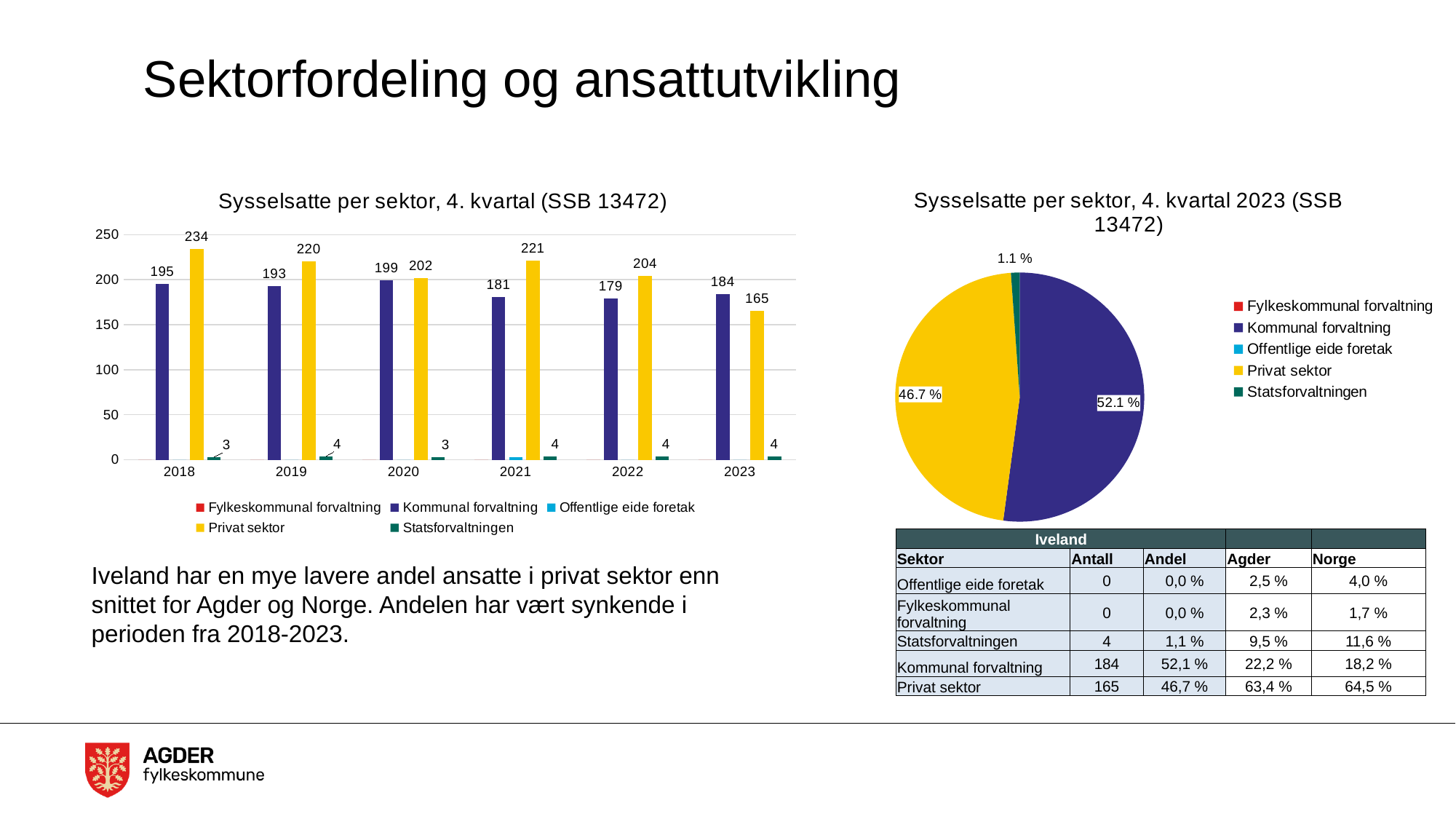
In the pie chart 'Sysselsatte per sektor, 4. kvartal 2023 (SSB 13472)', what share does Kommunal forvaltning have? 52.1 % In the pie chart 'Sysselsatte per sektor, 4. kvartal 2023 (SSB 13472)', what share does Statsforvaltningen have? 1.1 % In the bar chart 'Sysselsatte per sektor, 4. kvartal (SSB 13472)', in which year is Privat sektor highest? 2018 In the bar chart 'Sysselsatte per sektor, 4. kvartal (SSB 13472)', which is larger in 2021: Kommunal forvaltning or Privat sektor? Privat sektor In the bar chart 'Sysselsatte per sektor, 4. kvartal (SSB 13472)', what is the difference between Privat sektor and Kommunal forvaltning in 2023? 19 What kind of chart is 'Sysselsatte per sektor, 4. kvartal (SSB 13472)' on the left of the slide? Bar chart In the bar chart 'Sysselsatte per sektor, 4. kvartal (SSB 13472)', in which year is Privat sektor lowest? 2023 In the bar chart 'Sysselsatte per sektor, 4. kvartal (SSB 13472)', how many years are shown on the x axis? 6 In the bar chart 'Sysselsatte per sektor, 4. kvartal (SSB 13472)', what is the value for Statsforvaltningen in 2020? 3 In the bar chart 'Sysselsatte per sektor, 4. kvartal (SSB 13472)', what is the value for Kommunal forvaltning in 2022? 179 In the bar chart 'Sysselsatte per sektor, 4. kvartal (SSB 13472)', how many series does the legend list? 5 In the bar chart 'Sysselsatte per sektor, 4. kvartal (SSB 13472)', what is the value for Privat sektor in 2018? 234